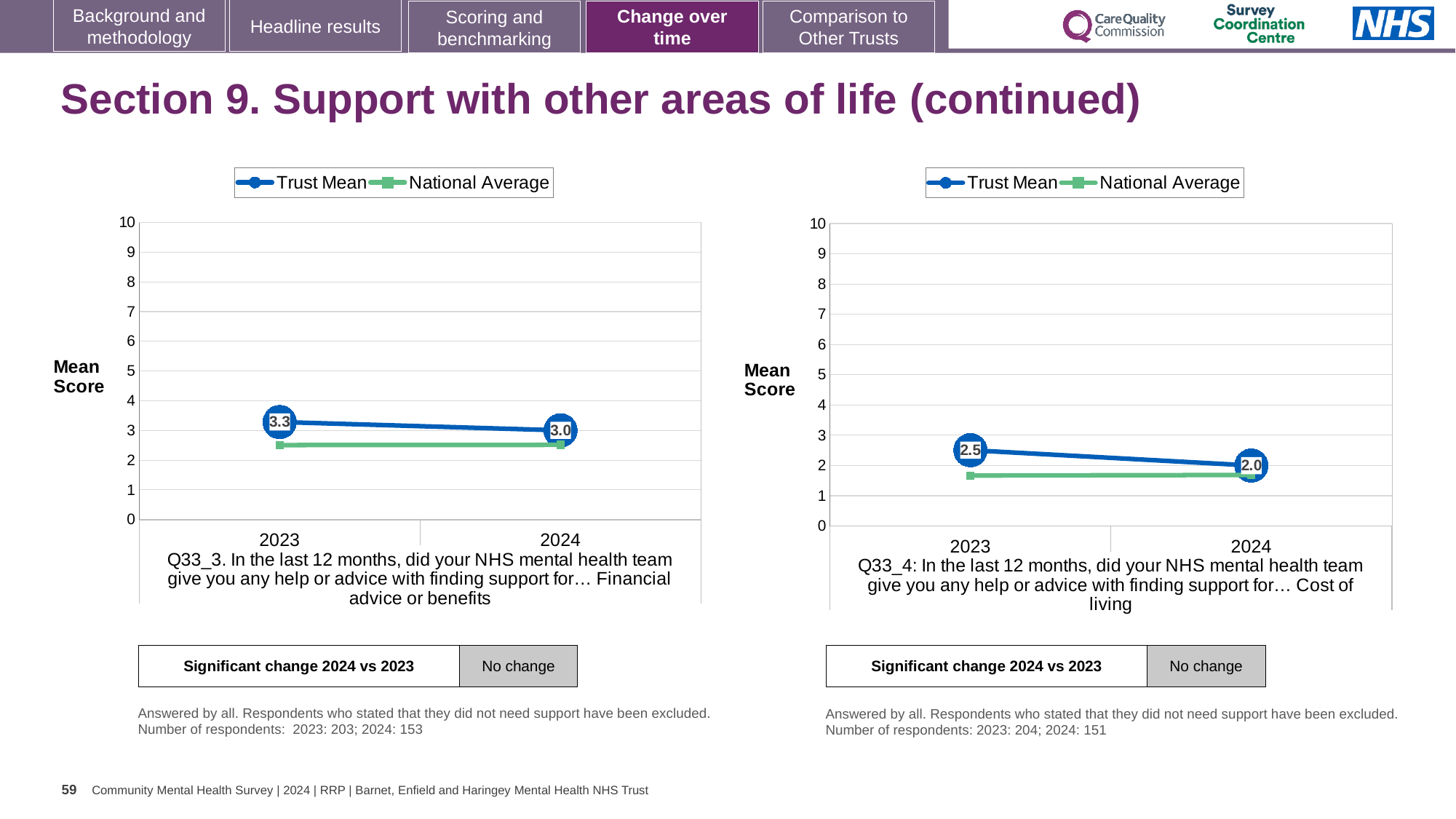
On the left chart (Q33_3, Financial advice or benefits), what is the Trust Mean for 2024? 3.0 On the right chart (Q33_4), what is the difference between the Trust Mean in 2023 and 2024? 0.5 On the right chart (Q33_4, Cost of living), what is the Trust Mean for 2023? 2.5 On the right chart (Q33_4), is the National Average for 2024 greater or less than 2? less What type of chart is used on the right side of the slide (Q33_4)? line chart On the right chart (Q33_4, Cost of living), what is the Trust Mean for 2024? 2.0 On the left chart (Q33_3), is the National Average for 2023 greater or less than 3? less On the left chart (Q33_3, Financial advice or benefits), what is the Trust Mean for 2023? 3.3 On the left chart (Q33_3), is the Trust Mean for 2023 higher or lower than the Trust Mean for 2024? higher How many series does the legend of the left chart list? 2 On the left chart (Q33_3), by how much did the Trust Mean change from 2023 to 2024? 0.3 On the right chart (Q33_4), does the Trust Mean rise or fall from 2023 to 2024? fall